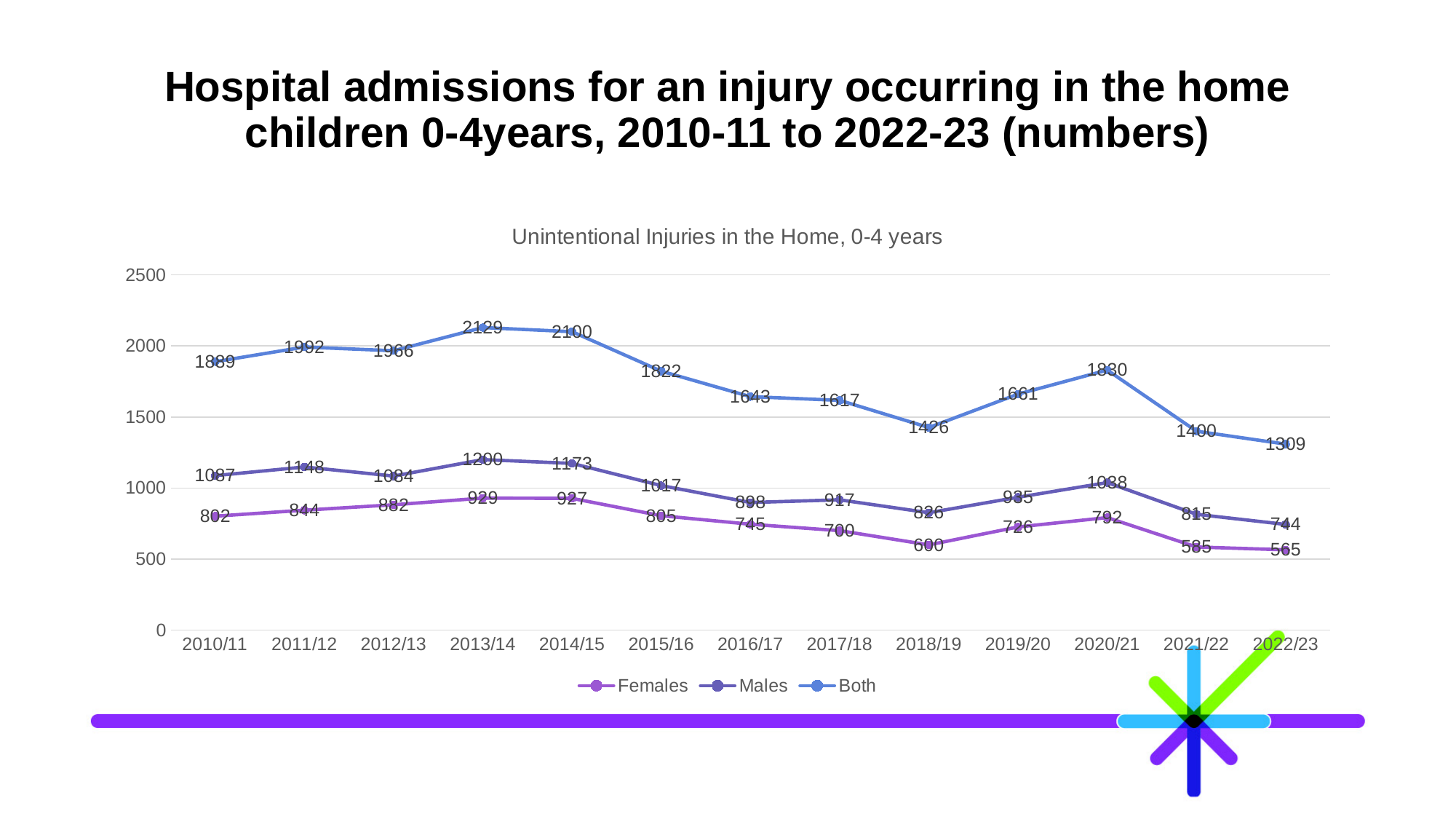
How many series does the legend list? 3 In which year is the Females series lowest? 2022/23 Is the value for Both in 2018/19 greater or less than 1500? less What is the difference between the Both value in 2013/14 and the Both value in 2022/23? 820 In which year is the Both series highest? 2013/14 How many years are plotted along the x axis? 13 What is the value for Males in 2022/23? 744 Which year has the larger Males value, 2019/20 or 2020/21? 2020/21 What is the value for Both in 2013/14? 2129 What kind of chart is shown on the slide? line chart What is the title printed above the chart area? Unintentional Injuries in the Home, 0-4 years What is the value for Females in 2018/19? 600